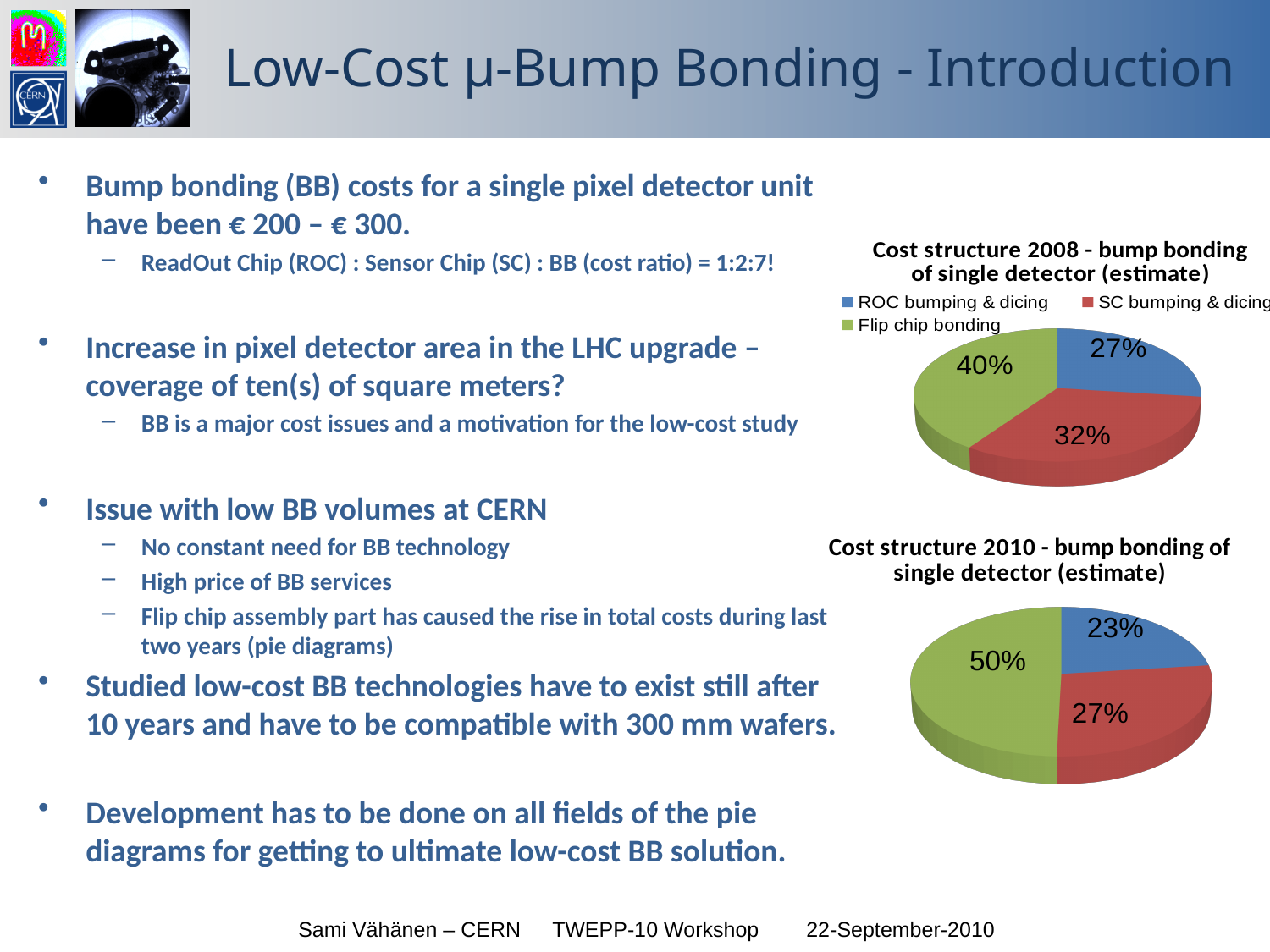
In the 'Cost structure 2008' pie chart, which category has the smallest share? ROC bumping & dicing Which is larger: the Flip chip bonding share in the 2008 pie chart or the green Flip chip bonding slice in the 2010 pie chart? 2010 (50%) In the 'Cost structure 2008' pie chart, what share is SC bumping & dicing? 32% In the 'Cost structure 2008' pie chart, which category has the largest share? Flip chip bonding In the 'Cost structure 2010' pie chart, what share does the green slice (Flip chip bonding) have? 50% In the 'Cost structure 2008' pie chart, what share is ROC bumping & dicing? 27% In the 'Cost structure 2010' pie chart, what is the difference between the largest slice (50%) and the smallest slice (23%)? 27 percentage points In the 'Cost structure 2008' pie chart, what is the difference between the Flip chip bonding share and the ROC bumping & dicing share? 13 percentage points What type of chart is 'Cost structure 2010 - bump bonding of single detector (estimate)'? Pie chart How many categories does the legend of the 'Cost structure 2008' pie chart list? 3 In the 'Cost structure 2010' pie chart, what share does the blue slice (ROC bumping & dicing) have? 23% In the 'Cost structure 2008' pie chart, what share is Flip chip bonding? 40%